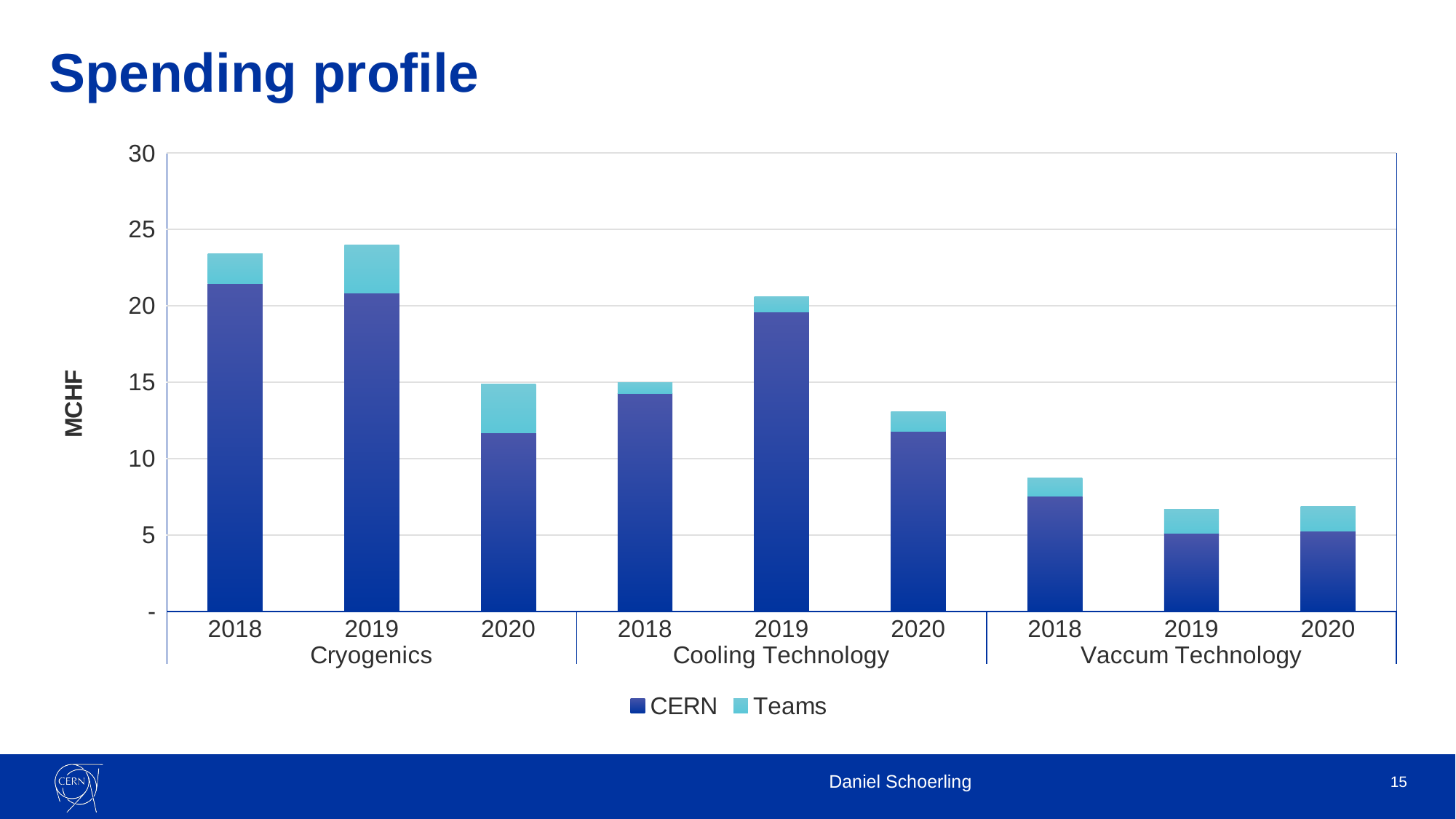
Is the total value for Cryogenics in 2020 greater or less than 10? greater Is the total value for Cooling Technology in 2020 greater or less than 15? less Within Cryogenics, does the total spending rise or fall from 2019 to 2020? Fall How many bars are plotted in the chart? 9 How many series does the legend list? 2 Is the total value for Cryogenics in 2018 greater or less than 20? greater What is the label on the y axis? MCHF Within Cooling Technology, which year has the larger total bar: 2019 or 2020? 2019 How many technology groups are shown along the x axis? 3 What kind of chart is shown on the slide? Stacked bar chart Which has the larger total bar: Cryogenics 2018 or Cooling Technology 2018? Cryogenics 2018